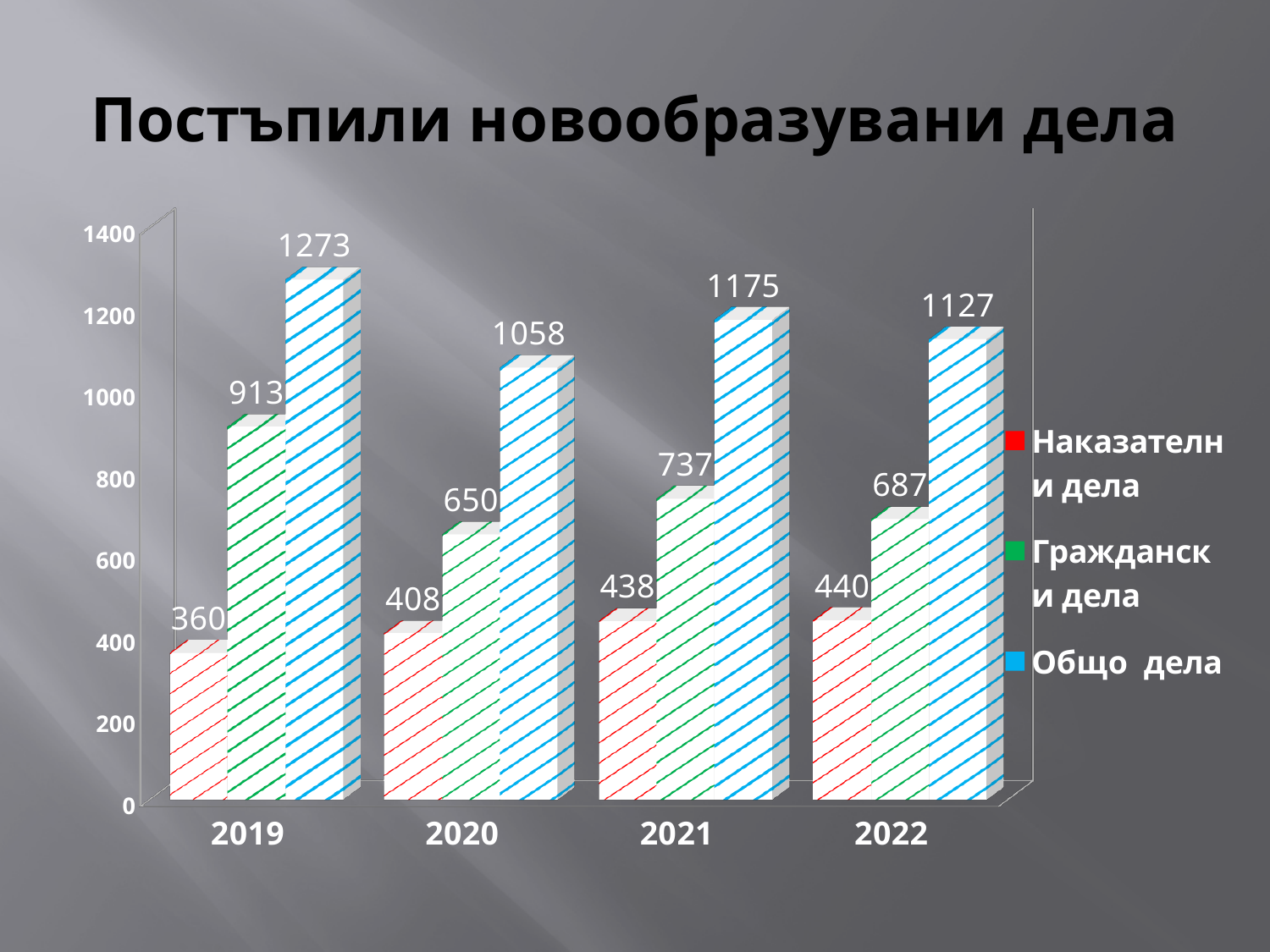
Which is larger: Наказателни дела in 2020 or in 2022? 2022 What is the difference between Общо дела in 2021 and 2022? 48 What is the title of the chart? Постъпили новообразувани дела How many series does the legend list? 3 What is the value for Наказателни дела in 2019? 360 What kind of chart is shown? bar chart Does Наказателни дела rise or fall from 2019 to 2022? rise What is the value for Граждански дела in 2021? 737 What is the value for Общо дела in 2020? 1058 How many years are shown on the x axis? 4 In which year is Общо дела highest? 2019 In which year is Граждански дела lowest? 2020